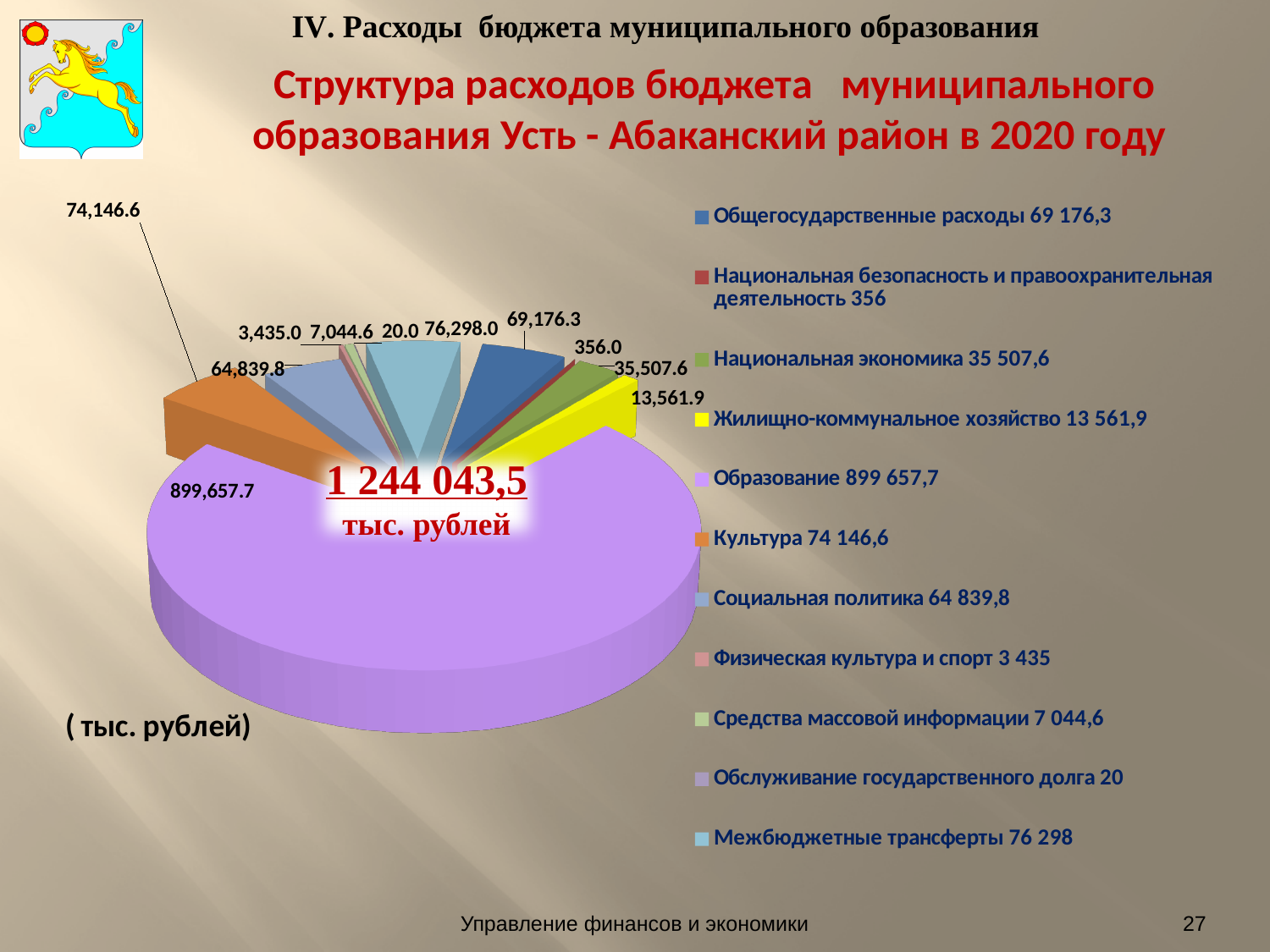
What type of chart is shown on the slide? Pie chart What total amount is printed in the centre of the pie chart? 1 244 043,5 тыс. рублей What is the value for Культура (Culture) on the pie chart? 74,146.6 What is the value for Межбюджетные трансферты on the pie chart? 76,298.0 Which is larger: Общегосударственные расходы or Социальная политика? Общегосударственные расходы How many categories does the pie chart have? 11 What is the value for Образование (Education) on the pie chart? 899,657.7 What is the difference between the values for Национальная экономика and Жилищно-коммунальное хозяйство? 21,945.7 What is the difference between the values for Межбюджетные трансферты and Культура? 2,151.4 Which category has the smallest value on the pie chart? Обслуживание государственного долга Which category has the largest slice of the pie chart? Образование What is the value for Национальная экономика on the pie chart? 35,507.6